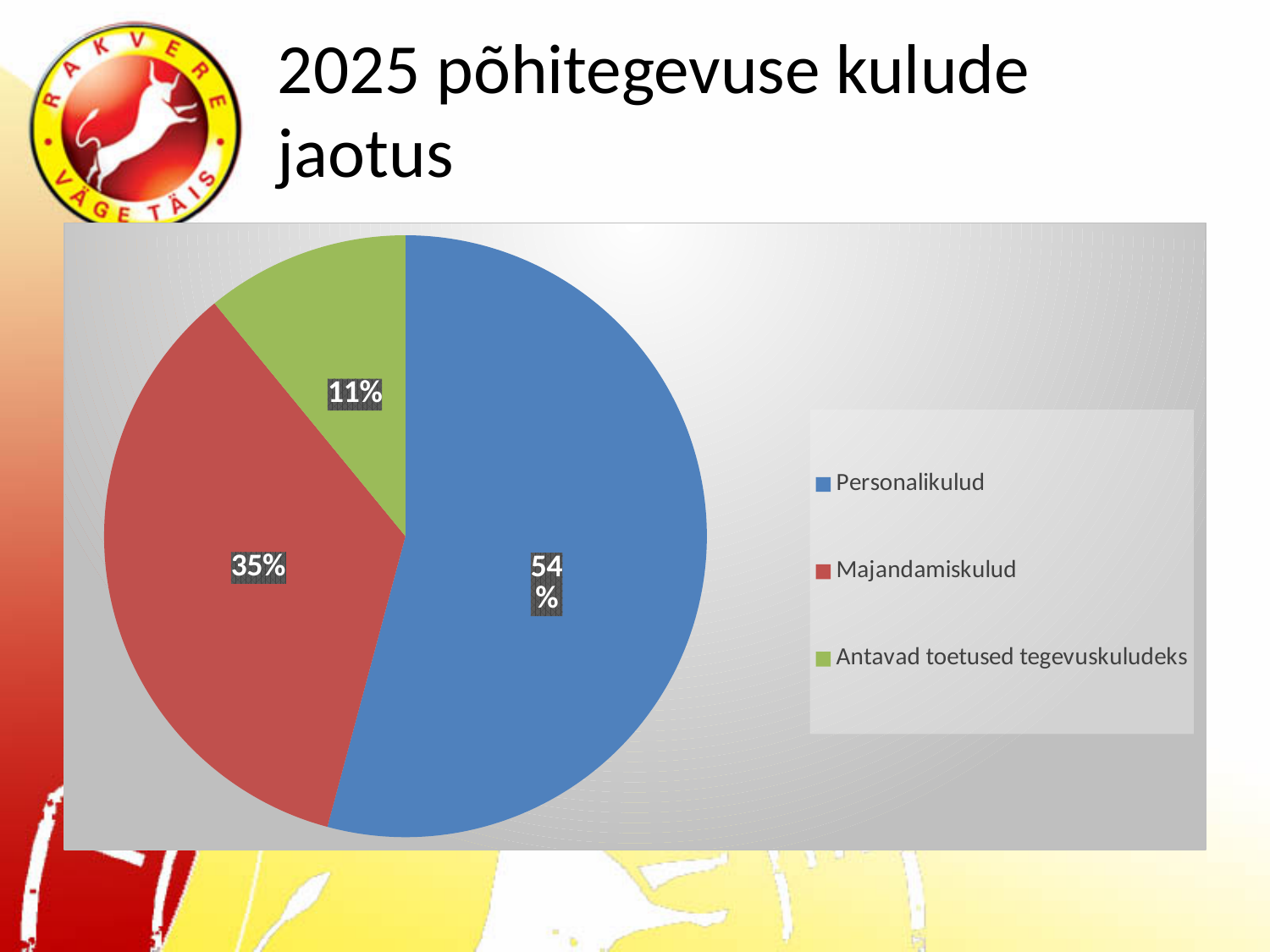
What is the title of the slide containing the chart? 2025 põhitegevuse kulude jaotus What kind of chart is shown on the slide? Pie chart Which category has the smallest slice of the pie? Antavad toetused tegevuskuludeks How many categories does the pie chart show? 3 What share of the pie does Majandamiskulud take? 35% What share of the pie does Personalikulud take? 54% What is the difference in percentage points between Majandamiskulud and Antavad toetused tegevuskuludeks? 24 Which category has the largest slice of the pie? Personalikulud What share of the pie does Antavad toetused tegevuskuludeks take? 11% What is the difference in percentage points between Personalikulud and Majandamiskulud? 19 Which colour represents Majandamiskulud in the legend? Red Which is larger, Majandamiskulud or Antavad toetused tegevuskuludeks? Majandamiskulud